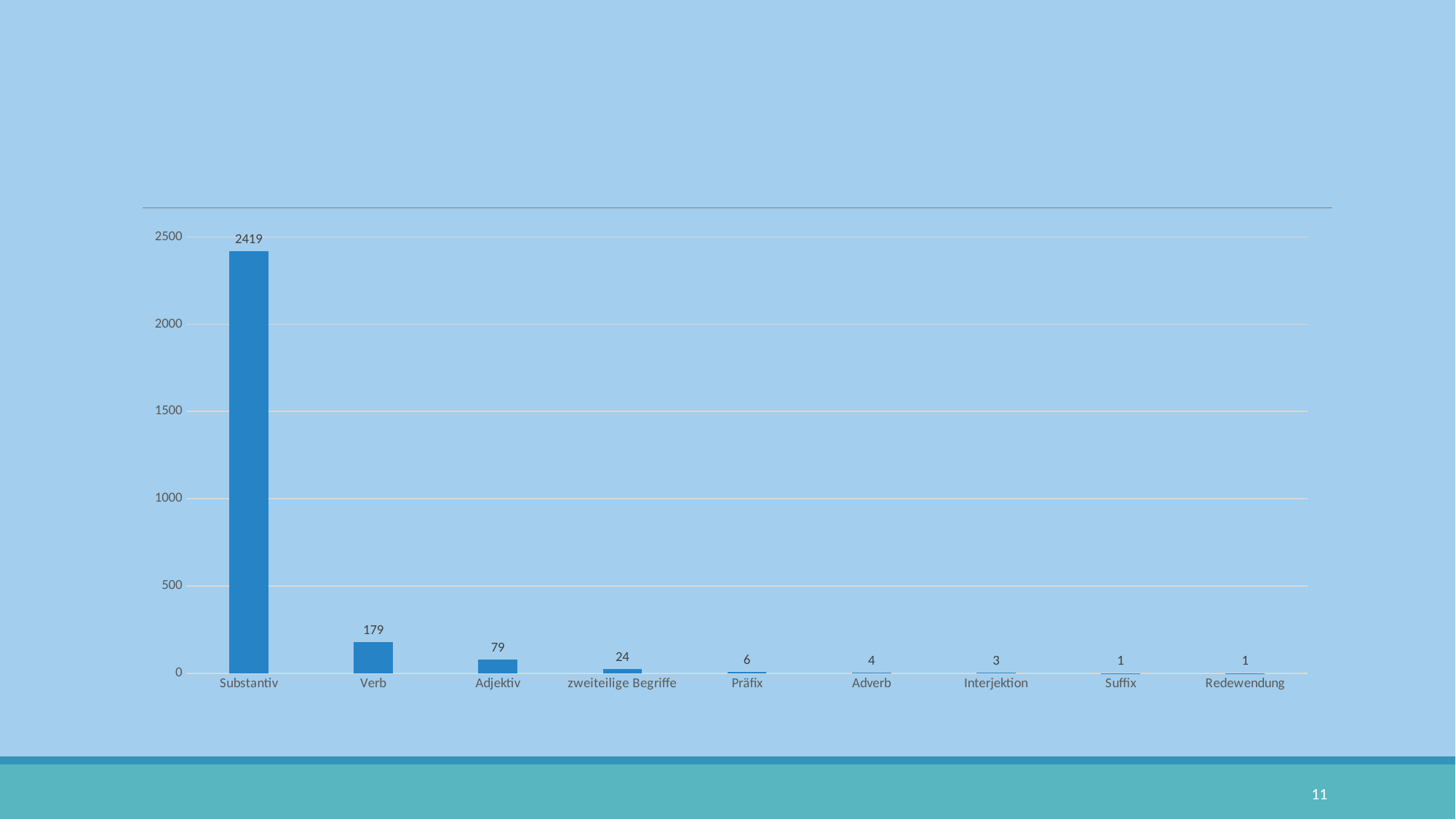
What is the difference between the values for Substantiv and Verb? 2240 How many categories are shown on the x axis? 9 Which category has the highest value? Substantiv Is the value for Substantiv greater or less than 2000? greater What is the value for Präfix? 6 Which is larger, the value for Adverb or the value for Interjektion? Adverb What is the value for Adjektiv? 79 What is the value for Verb? 179 What is the value for zweiteilige Begriffe? 24 What is the value for Substantiv? 2419 What is the difference between the values for Verb and Adjektiv? 100 What kind of chart is shown on the slide? bar chart